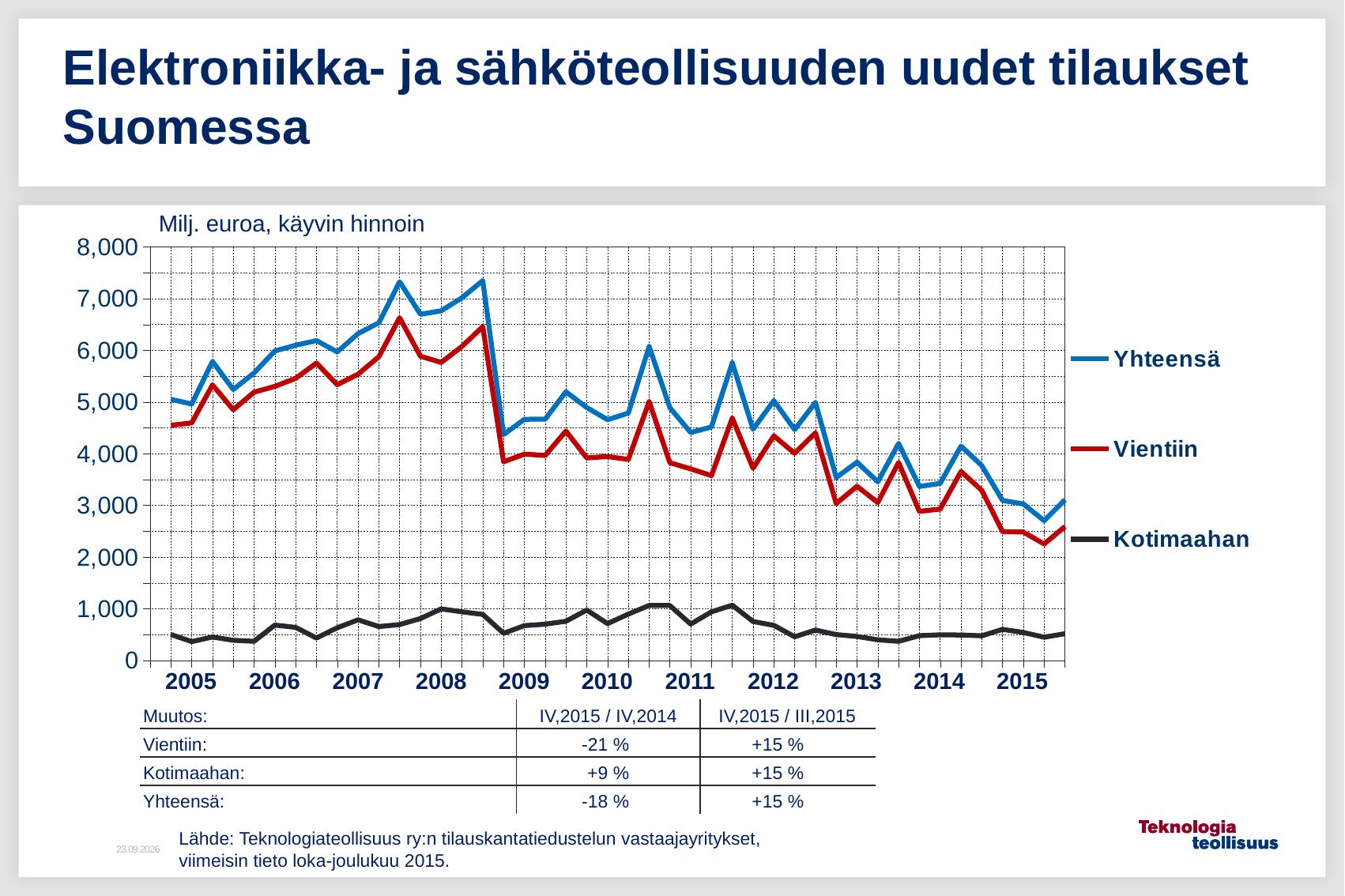
Is the last value for Vientiin in 2015 greater or less than 3,000? less How many years are labelled on the x axis of the chart? 11 What are the three series named in the chart legend? Yhteensä, Vientiin, Kotimaahan Which series has the lowest values throughout the whole period? Kotimaahan What kind of chart is shown on the slide? line chart Which series has the highest values throughout the whole period? Yhteensä Do the values for Yhteensä rise or fall from 2012 to 2015? fall Is the peak value of Yhteensä in 2008 greater or less than 7,000? greater In the table below the chart, what is the change for Vientiin in IV,2015 / IV,2014? -21 % How many series does the chart legend list? 3 What unit label is shown above the chart's y axis? Milj. euroa, käyvin hinnoin Is the value for Kotimaahan in 2005 greater or less than 2,000? less